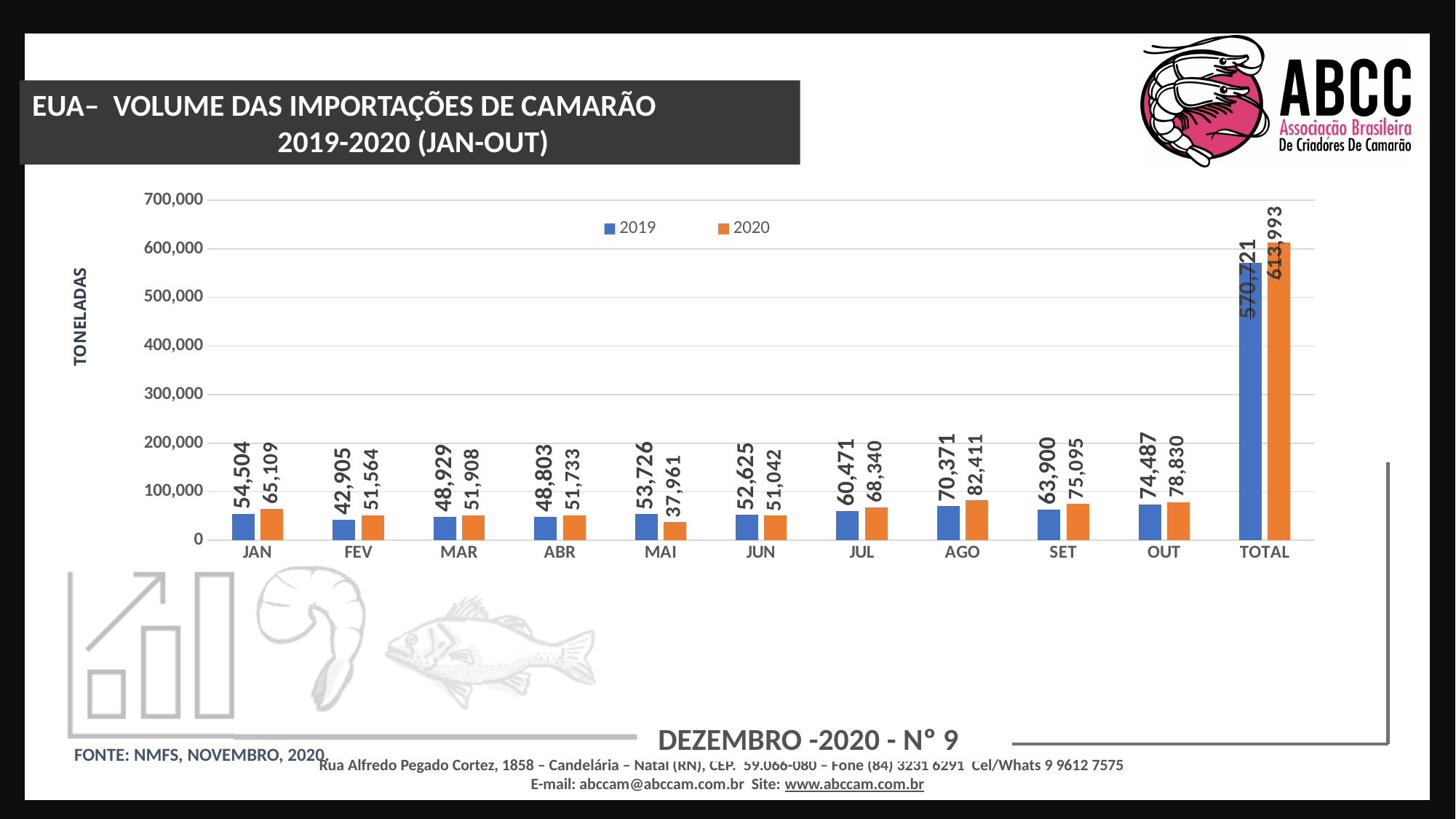
What is the difference between the 2020 and 2019 values for AGO? 12,040 Excluding TOTAL, which month has the lowest 2019 value? FEV For MAI, which series has the larger value, 2019 or 2020? 2019 Excluding TOTAL, which month has the highest 2020 value? AGO What is the 2020 value for TOTAL? 613,993 How many series does the legend list? 2 How many categories are shown on the x axis? 11 What is the 2020 value for JAN? 65,109 What is the 2019 value for MAI? 53,726 Is the 2019 value for TOTAL greater or less than 500,000? greater What kind of chart is shown on the slide? bar chart What is the difference between the 2020 and 2019 TOTAL values? 43,272